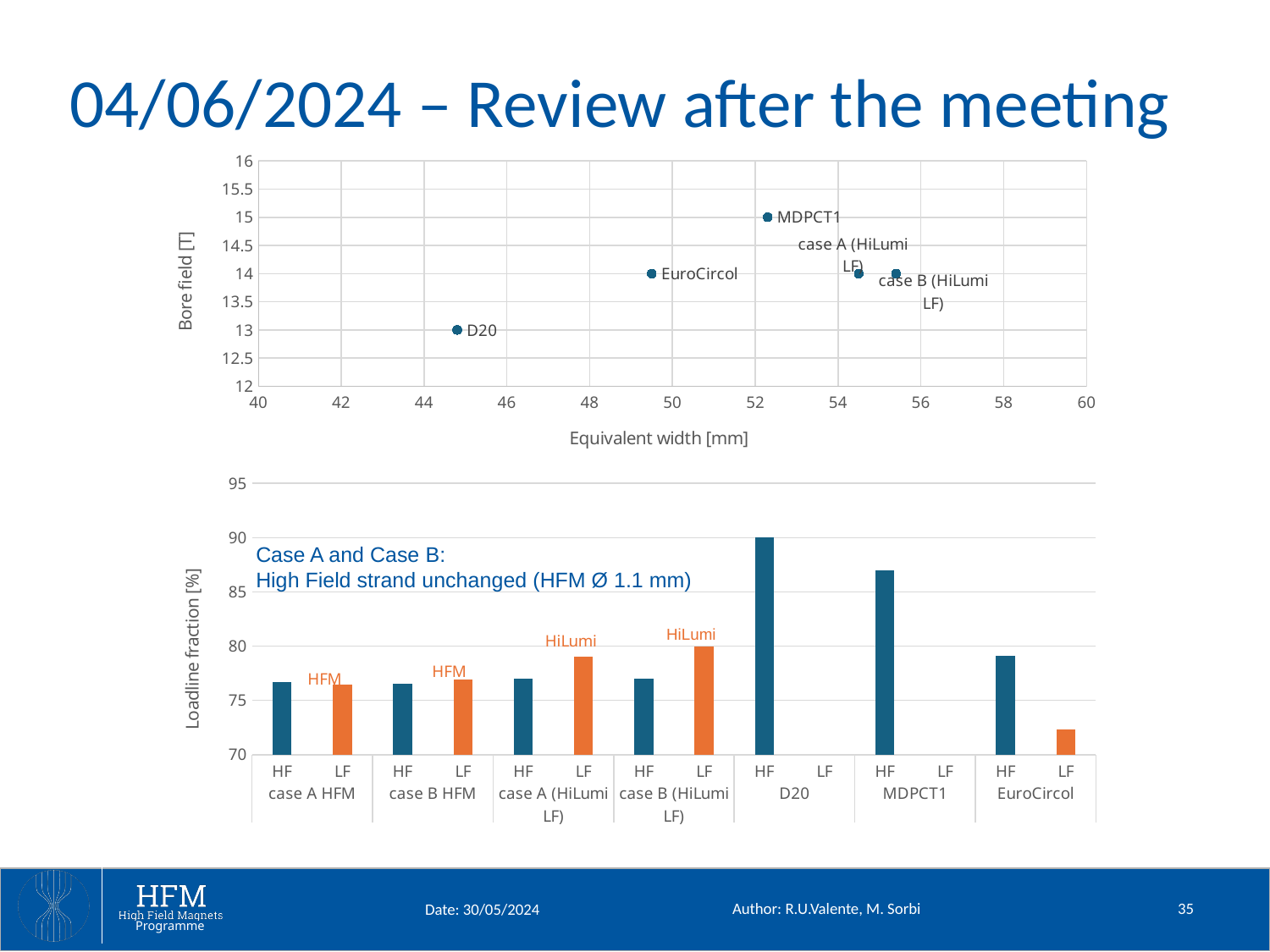
In the top chart, is the equivalent width for D20 greater or less than 46 mm? less In the bottom chart, which is larger, the HF or the LF loadline fraction for case B (HiLumi LF)? LF What kind of chart is the bottom chart (Loadline fraction)? bar chart In the top chart, how many data points are plotted? 5 In the bottom chart, is the loadline fraction for EuroCircol LF greater or less than 75%? less In the bottom chart, which bar has the highest loadline fraction? D20 HF In the top chart, which point has the lowest bore field? D20 In the bottom chart, how many magnet groups are shown on the x axis? 7 In the top chart, which point has the highest bore field? MDPCT1 What kind of chart is the top chart (Bore field vs Equivalent width)? scatter chart In the top chart, which has the larger equivalent width, D20 or EuroCircol? EuroCircol In the top chart, is the bore field for MDPCT1 greater or less than 14.5 T? greater